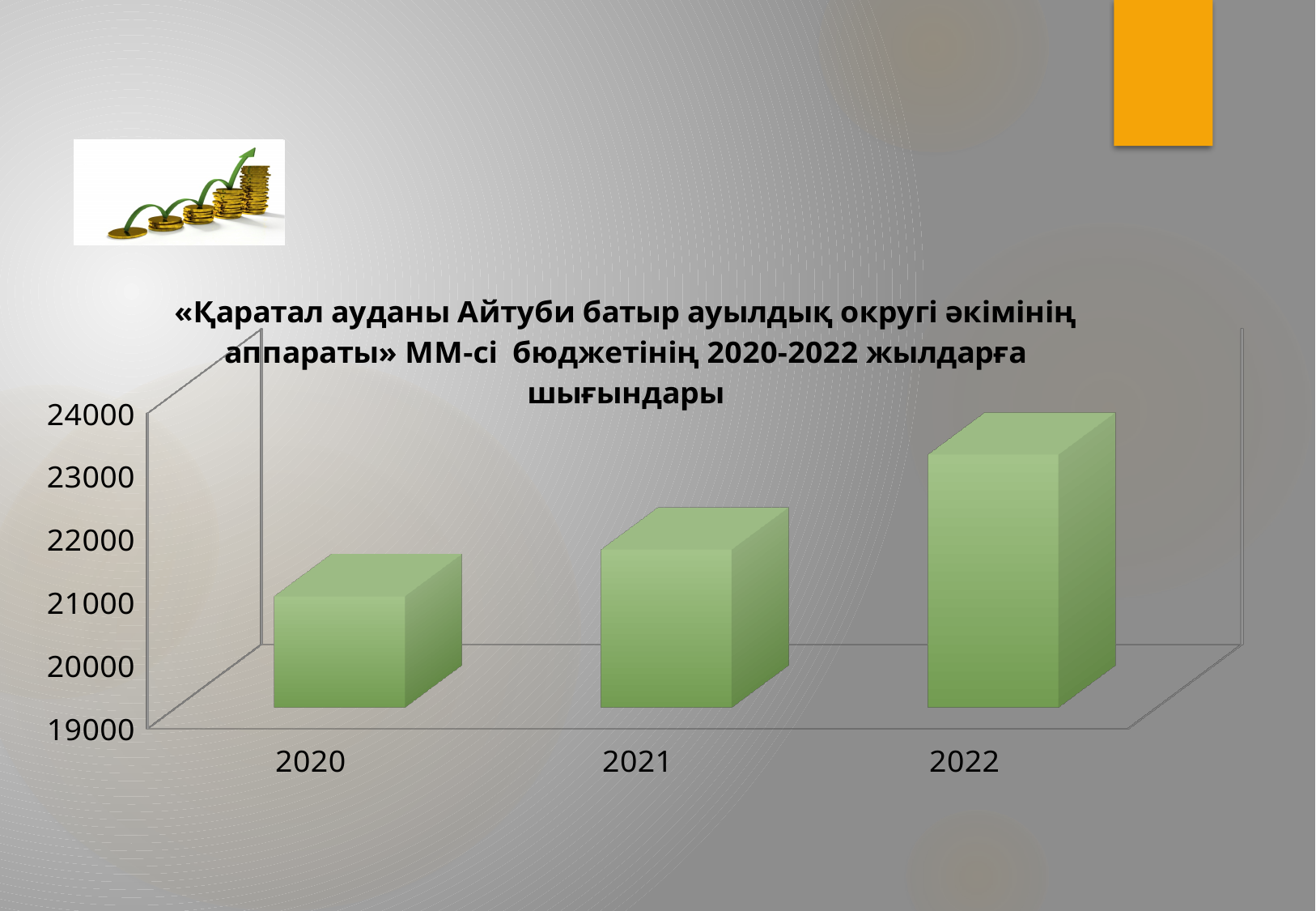
Do the values rise or fall from 2020 to 2022? rise What kind of chart is shown on the slide? bar chart Is the value for 2022 greater or less than 22000? greater Is the value for 2020 greater or less than 20000? greater Is the value for 2020 greater or less than 22000? less What is the lowest value shown on the vertical axis of the chart? 19000 Which is larger, the value for 2022 or the value for 2021? 2022 Which year has the lowest bar? 2020 How many years (categories) are plotted on the chart? 3 Which year has the highest bar? 2022 Which is larger, the value for 2021 or the value for 2020? 2021